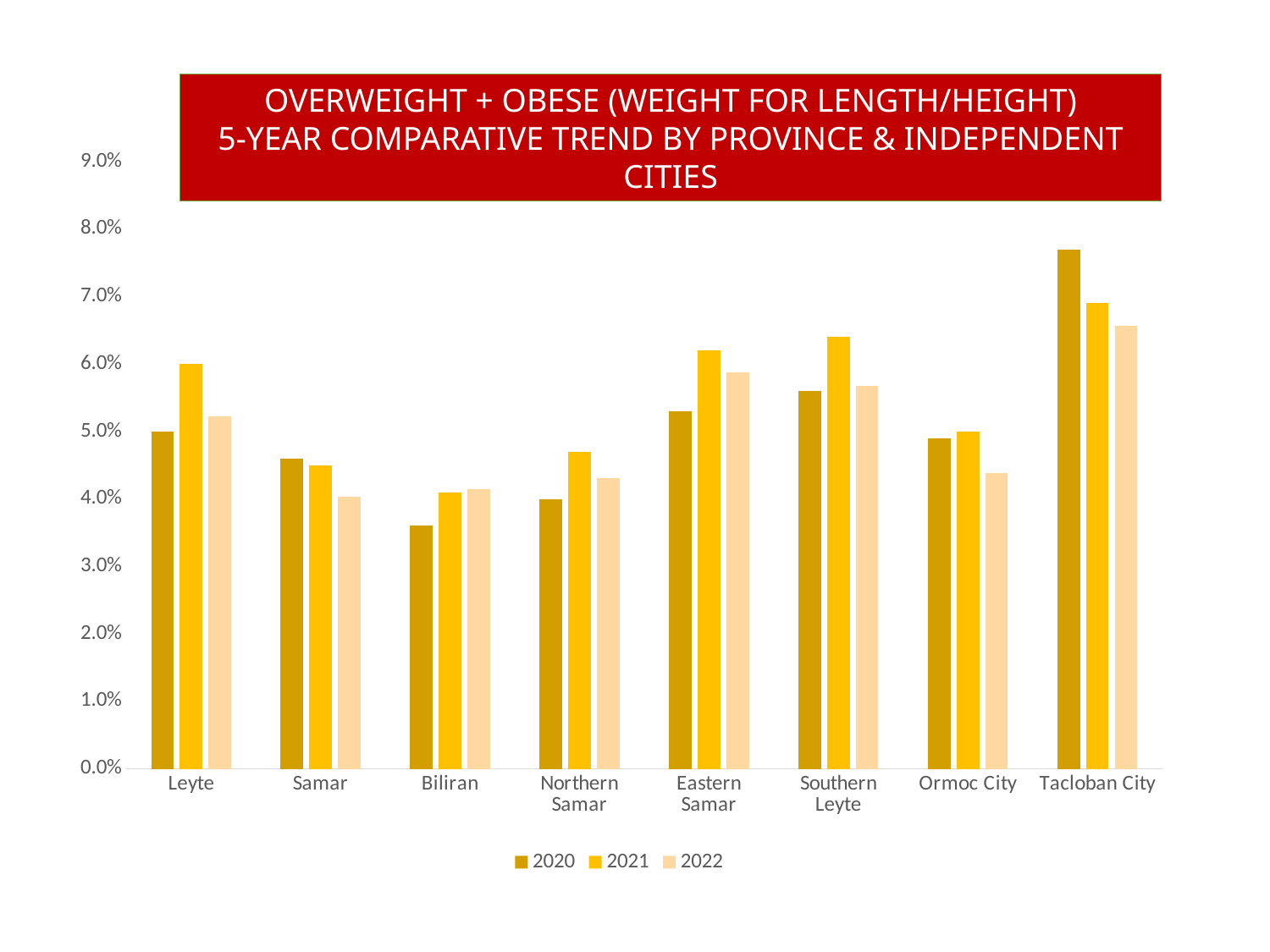
Is the 2022 value for Ormoc City greater or less than 5.0%? less Which province or city has the highest value for 2022? Tacloban City How many series does the legend list? 3 For Tacloban City, which is larger: the 2020 value or the 2021 value? 2020 Is the 2020 value for Tacloban City greater or less than 7.0%? greater Which province or city has the lowest value for 2020? Biliran Which province or city has the highest value for 2020? Tacloban City Do the values for Tacloban City rise or fall from 2020 to 2022? Fall Is the 2020 value for Biliran greater or less than 4.0%? less What kind of chart is shown on the slide? Bar chart How many provinces and cities are shown on the x axis? 8